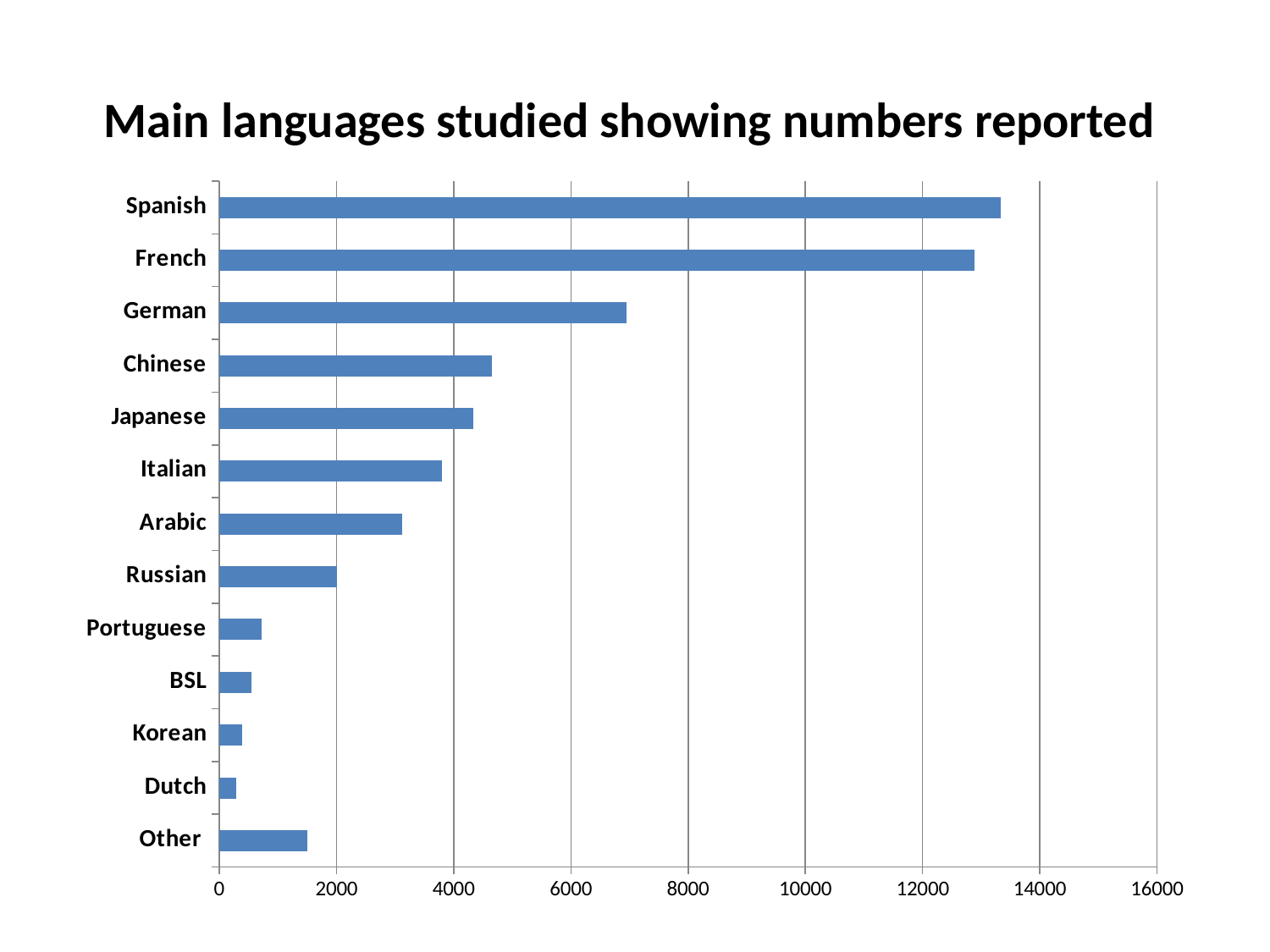
What is the title of the chart? Main languages studied showing numbers reported What type of chart is shown on the slide? bar chart Is the value for French greater or less than 12000? greater Which has a larger value, German or Chinese? German How many language categories are plotted in the chart? 13 Is the value for Other greater or less than 2000? less Which language has the highest number reported? Spanish Is the value for Chinese greater or less than 4000? greater Which has a larger value, Other or Portuguese? Other Which language has the lowest number reported? Dutch